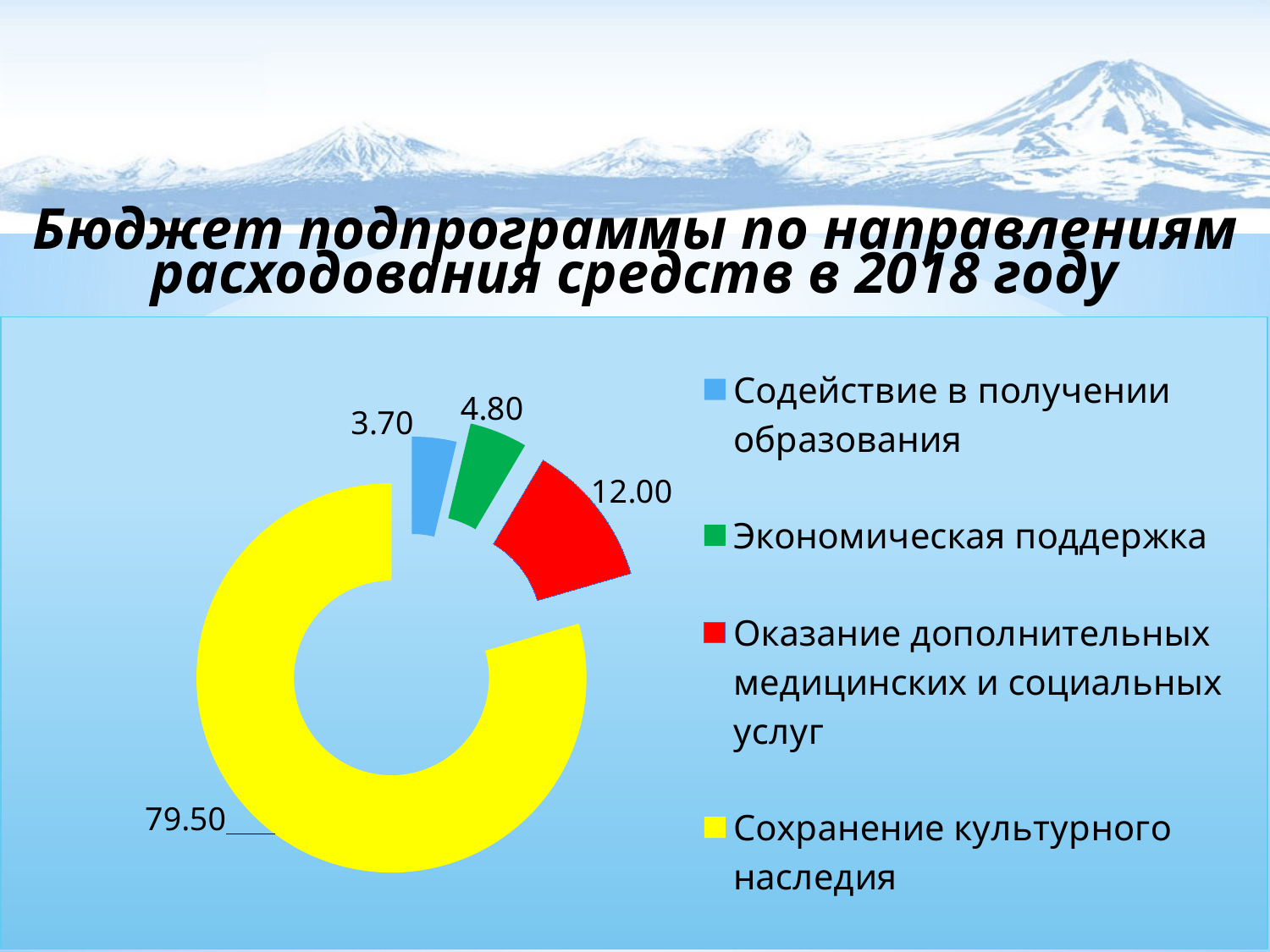
Which category has the largest share of the chart? Сохранение культурного наследия What value is shown for Содействие в получении образования? 3.70 What kind of chart is shown on the slide? Doughnut (pie) chart How many categories are shown in the chart? 4 What value is shown for Оказание дополнительных медицинских и социальных услуг? 12.00 What is the total of all the values shown in the chart? 100.00 Which category has the smallest share of the chart? Содействие в получении образования What value is shown for Сохранение культурного наследия? 79.50 Which is larger: the value for Экономическая поддержка or the value for Содействие в получении образования? Экономическая поддержка What is the difference between the values for Оказание дополнительных медицинских и социальных услуг and Экономическая поддержка? 7.20 Which colour represents Оказание дополнительных медицинских и социальных услуг in the chart? Red What value is shown for Экономическая поддержка? 4.80